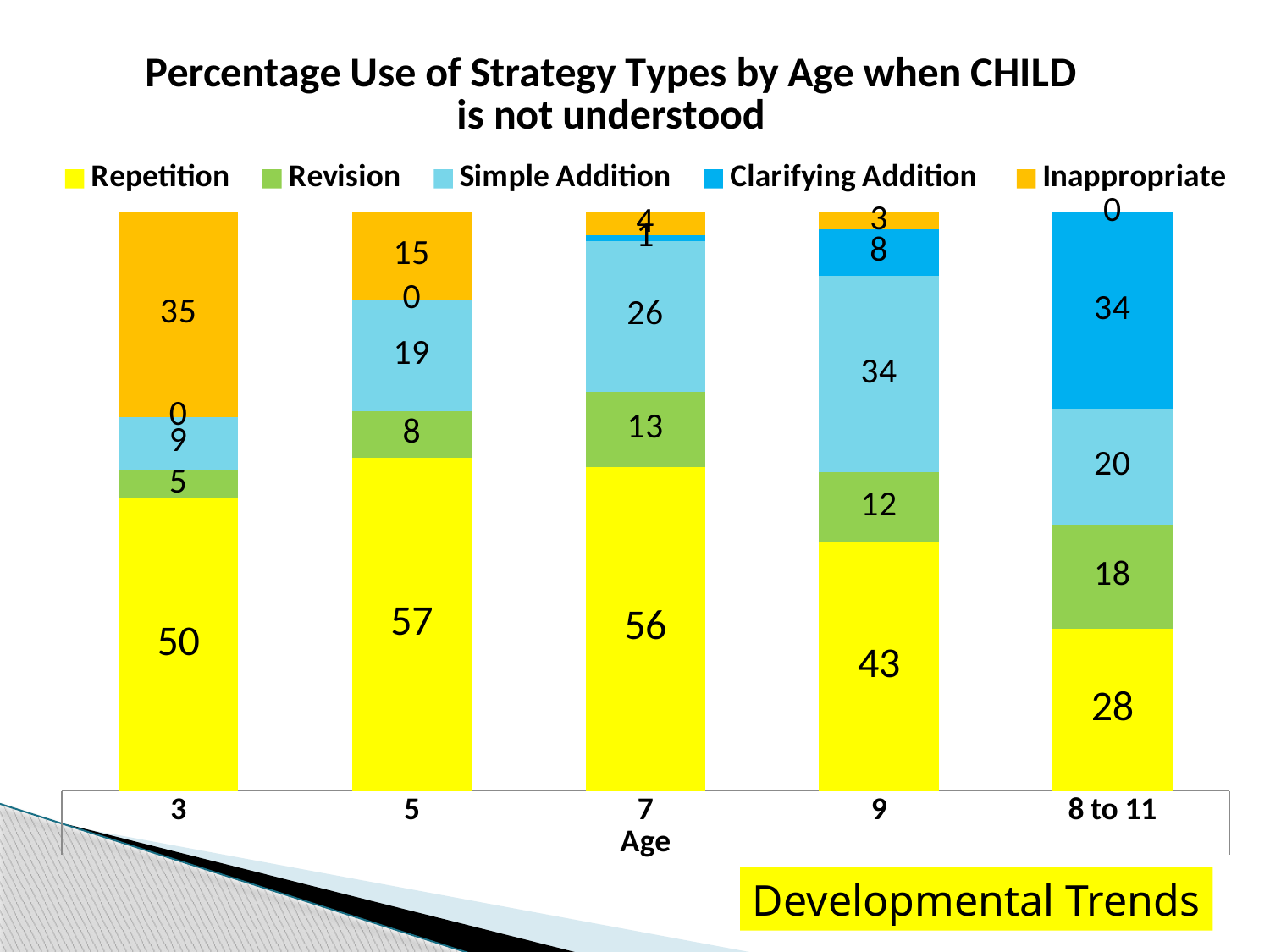
How many series does the legend list? 5 What is the Simple Addition value for age 9? 34 How many age categories are shown on the x axis? 5 Which age category has the lowest Repetition value? 8 to 11 Which is larger, the Revision value for age 7 or the Revision value for age 9? Age 7 What is the Clarifying Addition value for the 8 to 11 age group? 34 What type of chart is shown on the slide? Stacked bar chart What is the Inappropriate value for age 5? 15 What is the total of the stacked bar for age 7? 100 What is the Repetition value for age 3? 50 Which age category has the highest Repetition value? 5 What is the difference between the Inappropriate values for age 3 and age 5? 20